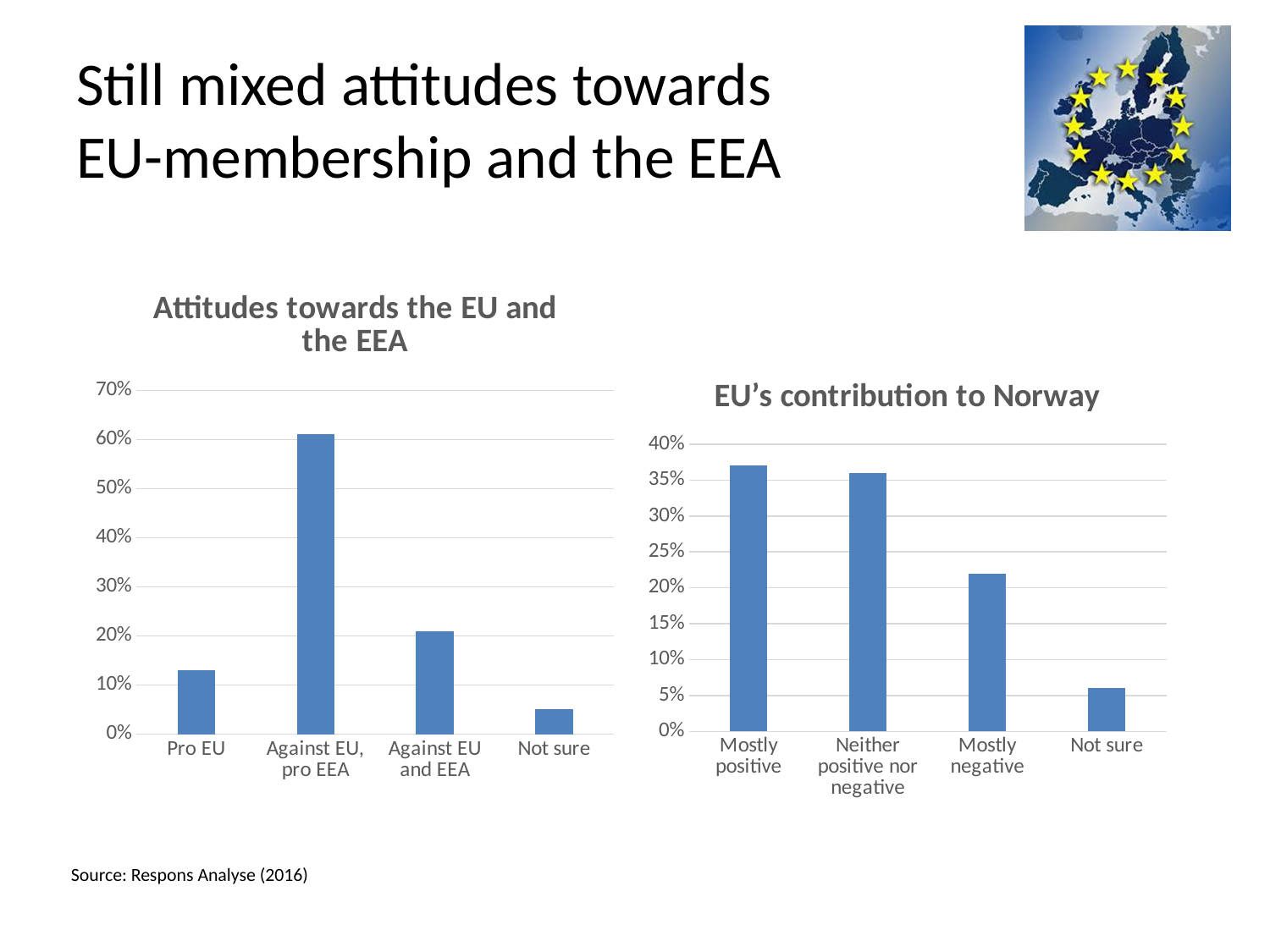
In the 'EU's contribution to Norway' chart, is the value for 'Mostly positive' greater or less than 30%? greater In the 'Attitudes towards the EU and the EEA' chart, which category has the lowest value? Not sure In the 'EU's contribution to Norway' chart, which category has the lowest value? Not sure In the 'Attitudes towards the EU and the EEA' chart, is the value for 'Pro EU' greater or less than 20%? less What kind of chart is the 'EU's contribution to Norway' chart? Bar chart How many categories are shown in the 'Attitudes towards the EU and the EEA' chart? 4 In the 'Attitudes towards the EU and the EEA' chart, which category has the highest value? Against EU, pro EEA In the 'Attitudes towards the EU and the EEA' chart, is the value for 'Against EU, pro EEA' greater or less than 50%? greater In the 'EU's contribution to Norway' chart, which is larger: 'Mostly negative' or 'Not sure'? Mostly negative In the 'Attitudes towards the EU and the EEA' chart, which is larger: 'Pro EU' or 'Against EU and EEA'? Against EU and EEA What is the title of the chart on the right side of the slide? EU's contribution to Norway